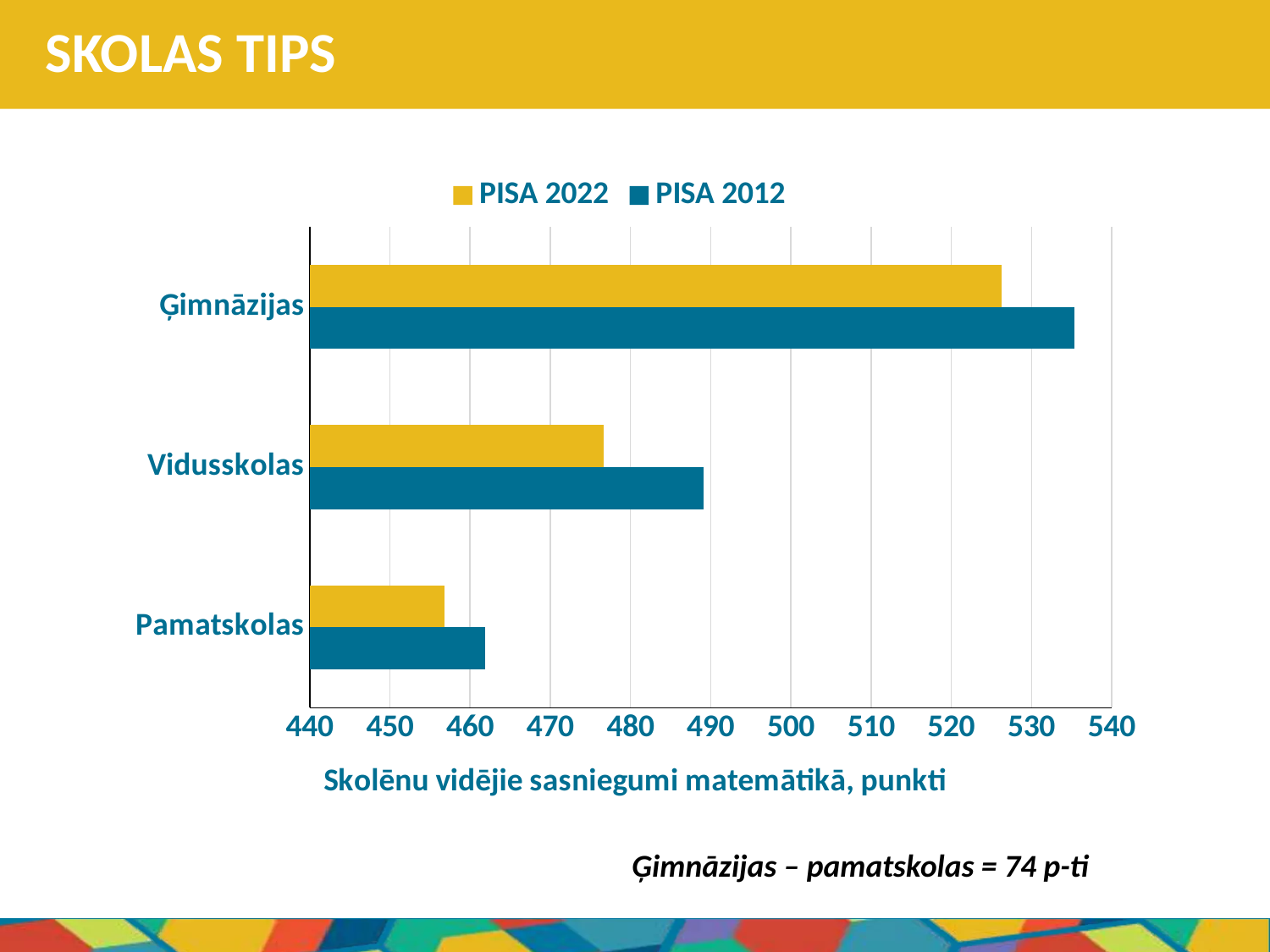
Is the PISA 2022 value for Vidusskolas greater or less than 480? less Is the PISA 2022 value for Ģimnāzijas greater or less than 520? greater How many series does the legend list? 2 Is the PISA 2022 value for Pamatskolas greater or less than 460? less What kind of chart is shown on the slide? bar chart Which category has the lowest PISA 2022 value? Pamatskolas What is the title of the horizontal axis? Skolēnu vidējie sasniegumi matemātikā, punkti Which category has the highest PISA 2012 value? Ģimnāzijas How many school-type categories are shown on the chart? 3 For Ģimnāzijas, which series has the larger value, PISA 2022 or PISA 2012? PISA 2012